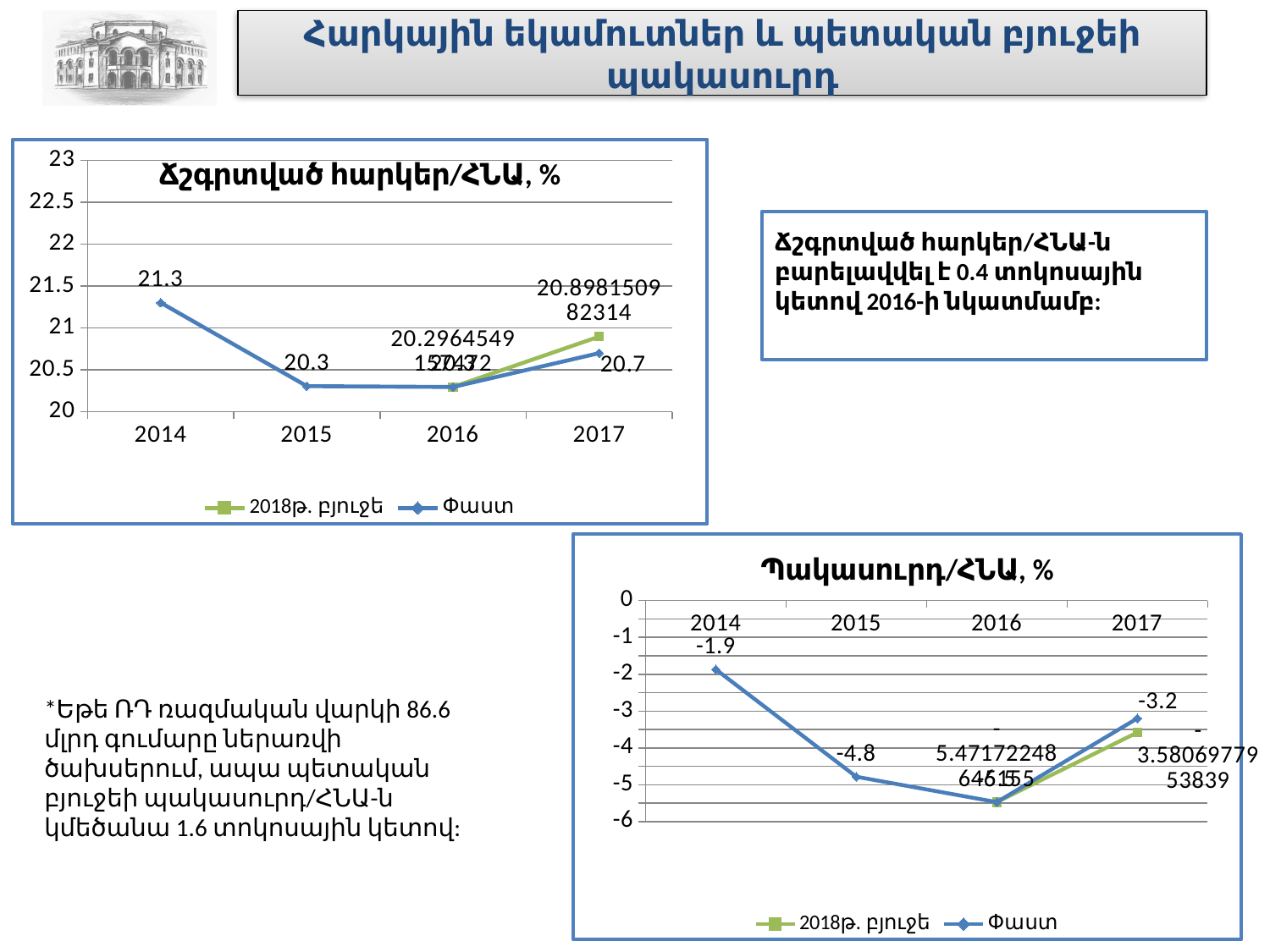
In the chart titled Ճշգրտված հարկեր/ՀՆԱ, %, which is larger, the Փաստ value for 2014 or for 2017? 2014 In the chart titled Պակասուրդ/ՀՆԱ, %, which year has the lowest Փաստ value? 2016 What kind of chart is the chart titled Պակասուրդ/ՀՆԱ, %? Line chart In the chart titled Ճշգրտված հարկեր/ՀՆԱ, %, what is the Փաստ value for 2017? 20.7 In the chart titled Պակասուրդ/ՀՆԱ, %, what is the Փաստ value for 2014? -1.9 In the chart titled Պակասուրդ/ՀՆԱ, %, what is the Փաստ value for 2015? -4.8 In the chart titled Ճշգրտված հարկեր/ՀՆԱ, %, which year has the highest Փաստ value? 2014 In the chart titled Պակասուրդ/ՀՆԱ, %, what is the Փաստ value for 2017? -3.2 In the chart titled Պակասուրդ/ՀՆԱ, %, how many years are shown on the x axis? 4 In the chart titled Ճշգրտված հարկեր/ՀՆԱ, %, what is the difference between the Փաստ values for 2014 and 2015? 1.0 In the chart titled Ճշգրտված հարկեր/ՀՆԱ, %, what is the Փաստ value for 2014? 21.3 In the chart titled Ճշգրտված հարկեր/ՀՆԱ, %, how many series does the legend list? 2